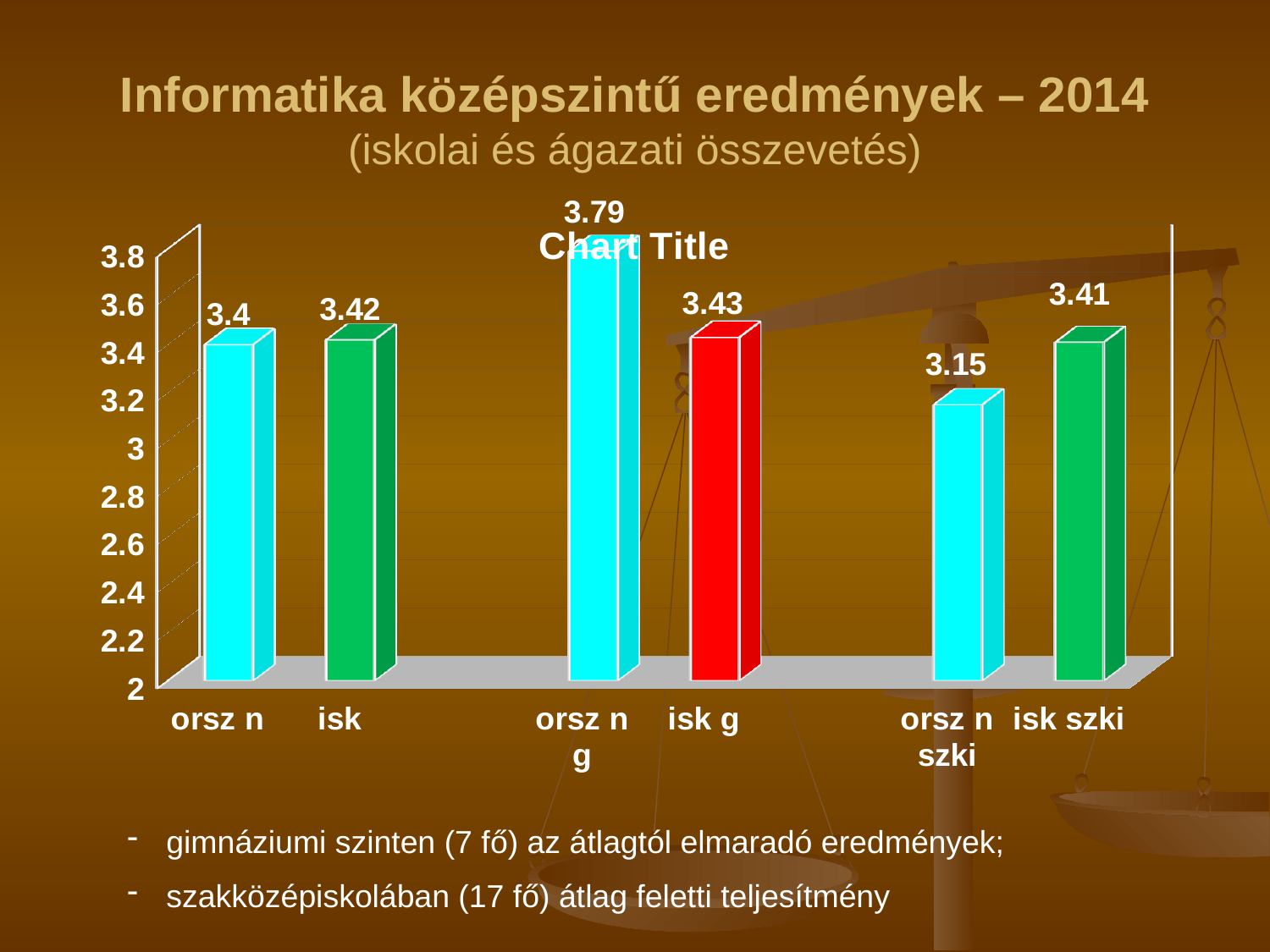
How many bars are plotted in the chart? 6 What is the title printed on the chart itself? Chart Title Which is larger, the value for "orsz n g" or the value for "isk g"? orsz n g What is the value for "isk g"? 3.43 Which category has the highest value? orsz n g What kind of chart is shown on the slide? bar chart Which category has the lowest value? orsz n szki What is the difference between the values for "orsz n g" and "isk g"? 0.36 What is the value for "orsz n szki"? 3.15 What is the difference between the values for "isk szki" and "orsz n szki"? 0.26 What is the value for "isk szki"? 3.41 What is the value for "orsz n"? 3.4